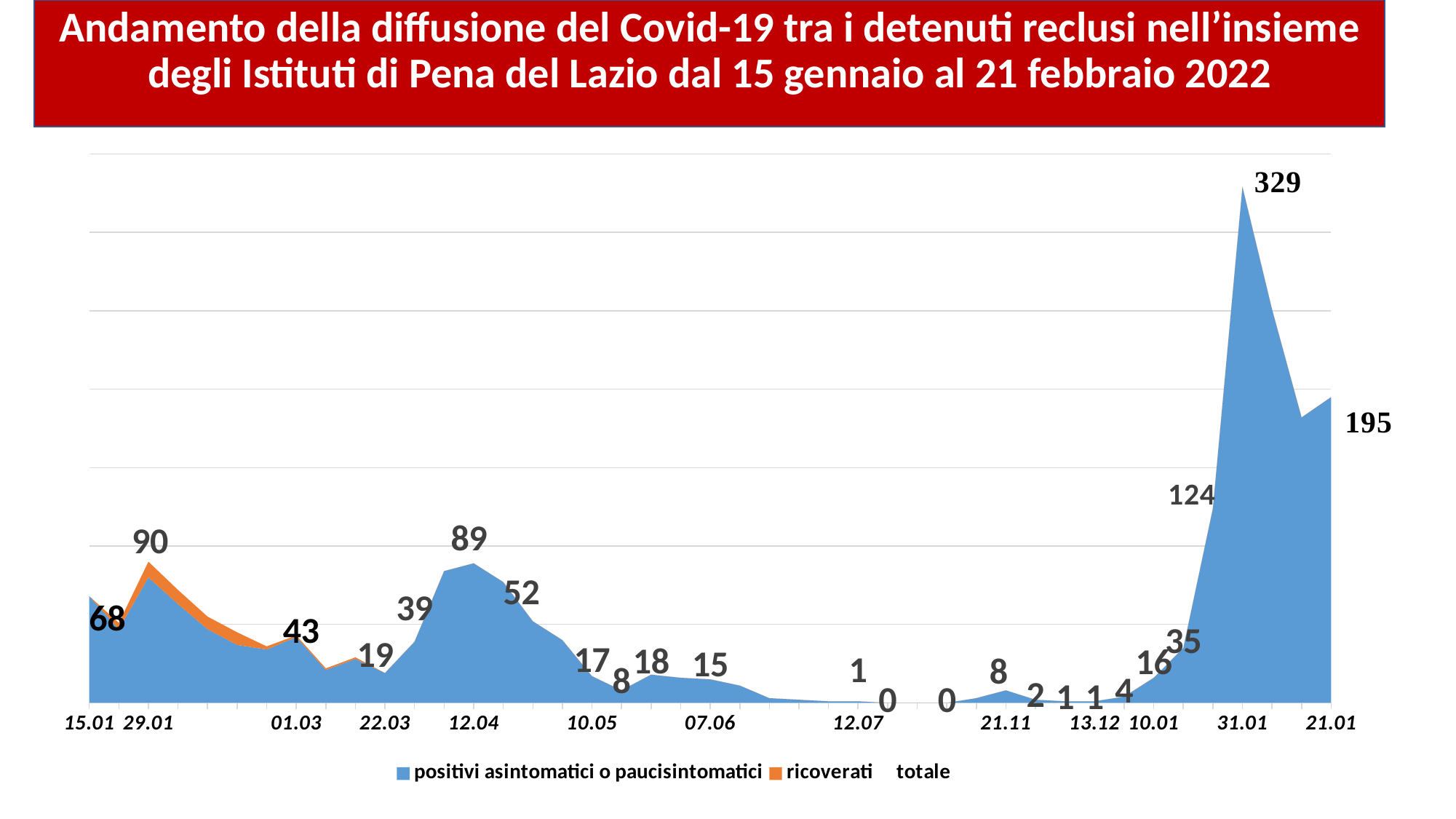
What is the value labelled at the first date, 15.01? 68 Which is larger, the value labelled 124 or the value labelled 195 at 21.01? 195 What is the value labelled at 29.01? 90 What is the highest value labelled on the chart? 329 How many series does the legend list? 3 What is the value labelled at the last date, 21.01? 195 What is the value labelled at 31.01? 329 At which date does the chart reach its peak value of 329? 31.01 What is the difference between the peak value of 329 and the final value of 195? 134 What type of chart is shown on the slide? area chart What is the lowest value labelled on the chart? 0 Do the values rise or fall between 10.01 and 31.01? rise